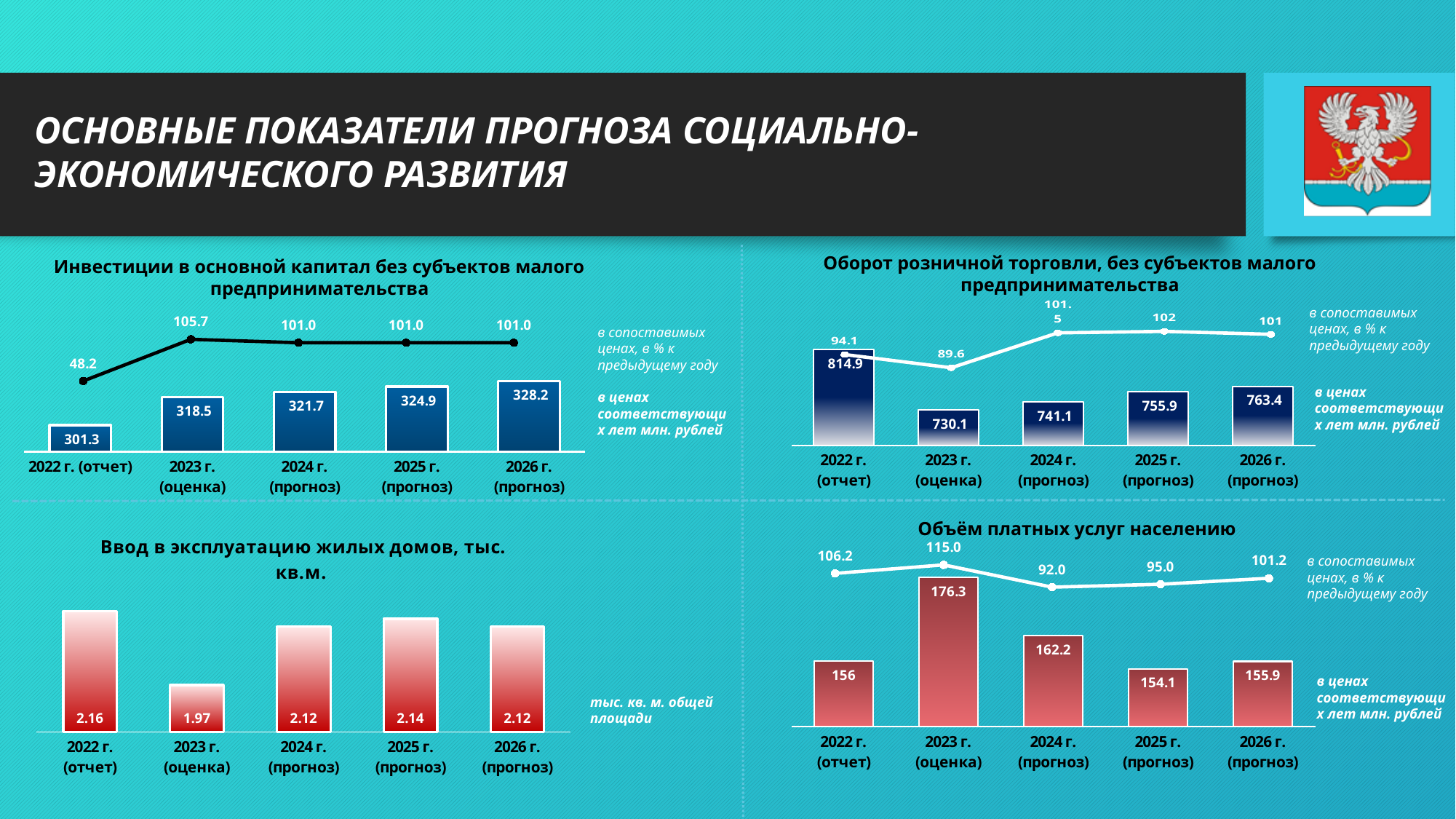
In the chart 'Ввод в эксплуатацию жилых домов, тыс. кв.м.', what is the value for 2025 г. (прогноз)? 2.14 How many bars are shown in the chart 'Ввод в эксплуатацию жилых домов, тыс. кв.м.'? 5 In the chart 'Ввод в эксплуатацию жилых домов, тыс. кв.м.', which year has the lowest value? 2023 г. (оценка) In the chart 'Оборот розничной торговли, без субъектов малого предпринимательства', what is the difference between the bar values for 2022 г. (отчет) and 2023 г. (оценка)? 84.8 In the chart 'Объём платных услуг населению', which year has the highest bar value? 2023 г. (оценка) In the chart 'Инвестиции в основной капитал без субъектов малого предпринимательства', what is the line value for 2022 г. (отчет)? 48.2 In the chart 'Оборот розничной торговли, без субъектов малого предпринимательства', what is the line value for 2023 г. (оценка)? 89.6 In the chart 'Объём платных услуг населению', which is larger: the bar value for 2024 г. (прогноз) or for 2025 г. (прогноз)? 2024 г. (прогноз) In the chart 'Инвестиции в основной капитал без субъектов малого предпринимательства', do the bar values rise or fall from 2022 to 2026? rise In the chart 'Инвестиции в основной капитал без субъектов малого предпринимательства', what is the bar value for 2024 г. (прогноз)? 321.7 In the chart 'Оборот розничной торговли, без субъектов малого предпринимательства', which year has the highest bar value? 2022 г. (отчет) What type of chart is 'Объём платных услуг населению'? Combined bar and line chart